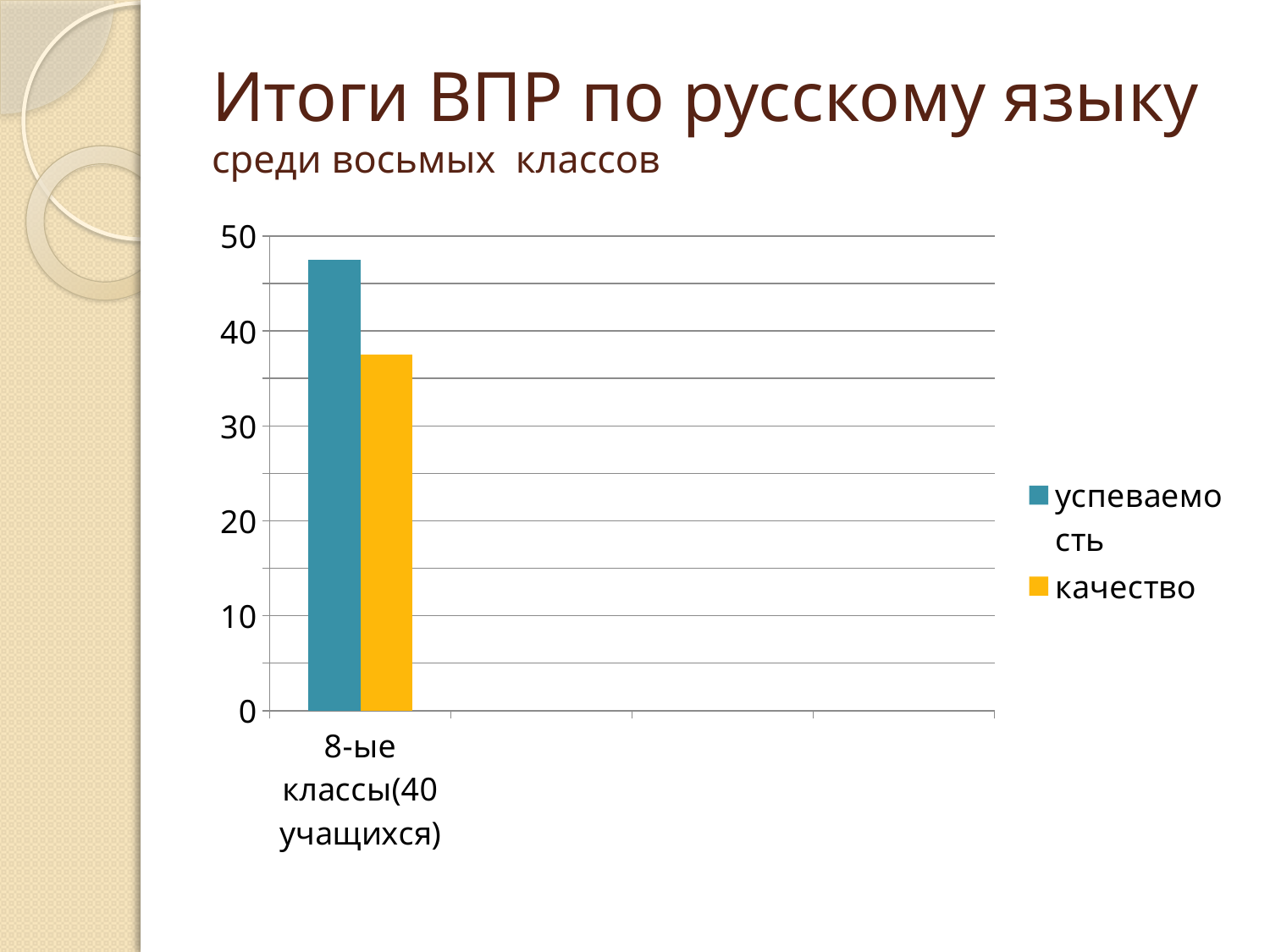
Which series has the taller bar for 8-ые классы(40 учащихся): успеваемость or качество? успеваемость Is the value for качество greater or less than 30? greater How many series does the legend list? 2 Is the value for успеваемость greater or less than 50? less What kind of chart is shown on the slide? bar chart How many categories are plotted on the x axis? 1 Which series has the highest bar in the chart? успеваемость What is the label of the single category on the x axis? 8-ые классы(40 учащихся) Which series is shown in yellow in the legend? качество Is the value for успеваемость greater or less than 40? greater Which series has the lowest bar in the chart? качество